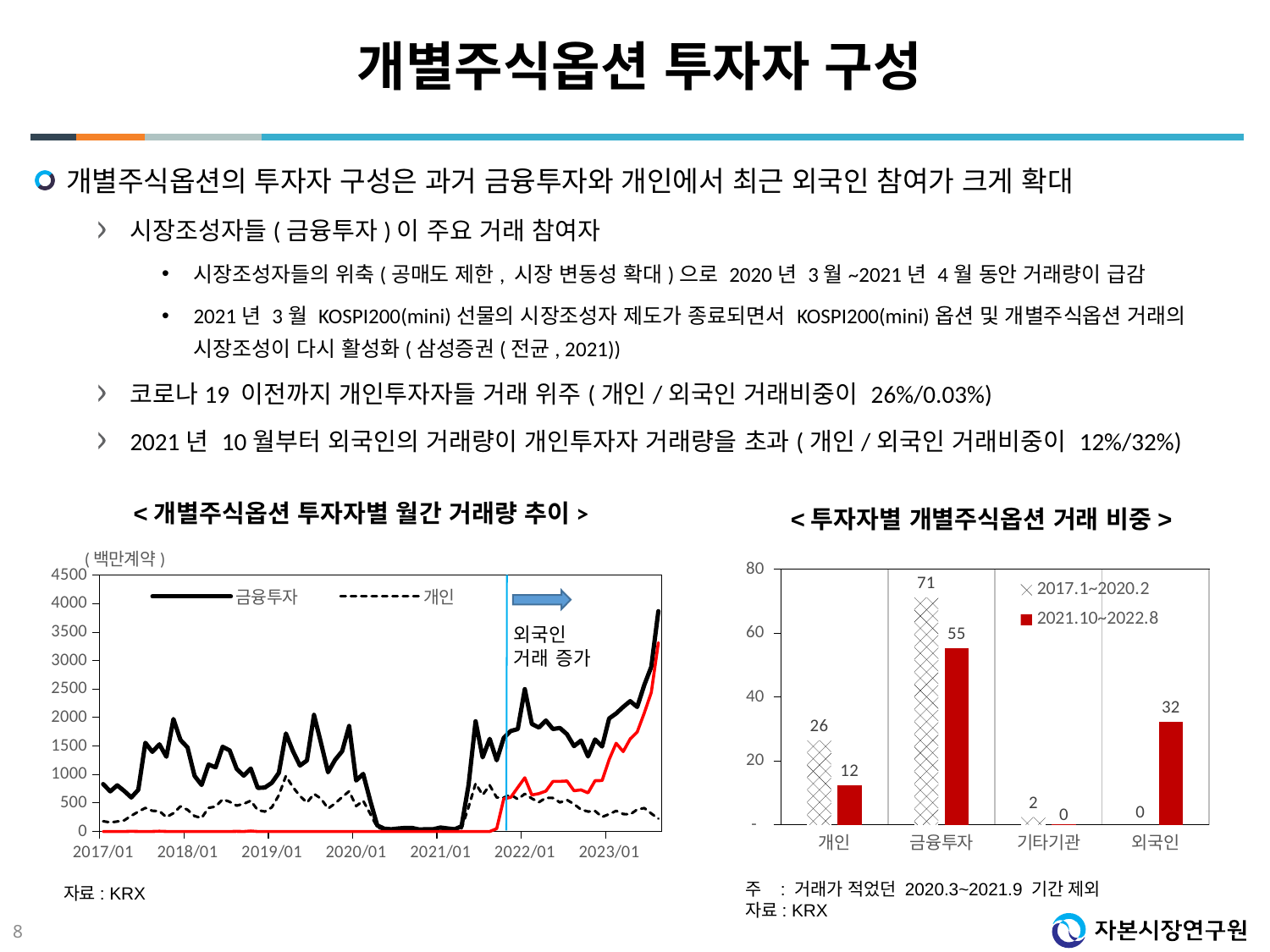
What kind of chart is the chart titled '개별주식옵션 투자자별 월간 거래량 추이'? line chart In the chart titled '투자자별 개별주식옵션 거래 비중', how many series does the legend list? 2 In the chart titled '투자자별 개별주식옵션 거래 비중', which category has the lowest value in the 2017.1~2020.2 series? 외국인 In the chart titled '투자자별 개별주식옵션 거래 비중', what is the value for 외국인 in the 2021.10~2022.8 series? 32 In the chart titled '투자자별 개별주식옵션 거래 비중', which category has the highest value in the 2021.10~2022.8 series? 금융투자 In the chart titled '투자자별 개별주식옵션 거래 비중', which is larger for 외국인: the 2017.1~2020.2 value or the 2021.10~2022.8 value? 2021.10~2022.8 What kind of chart is the chart titled '투자자별 개별주식옵션 거래 비중'? bar chart In the chart titled '투자자별 개별주식옵션 거래 비중', how many categories are shown on the x axis? 4 In the chart titled '투자자별 개별주식옵션 거래 비중', what is the value for 개인 in the 2021.10~2022.8 series? 12 In the chart titled '개별주식옵션 투자자별 월간 거래량 추이', what unit is shown above the y axis? 백만계약 In the chart titled '투자자별 개별주식옵션 거래 비중', what is the difference between the 2017.1~2020.2 and 2021.10~2022.8 values for 개인? 14 In the chart titled '투자자별 개별주식옵션 거래 비중', what is the value for 금융투자 in the 2017.1~2020.2 series? 71